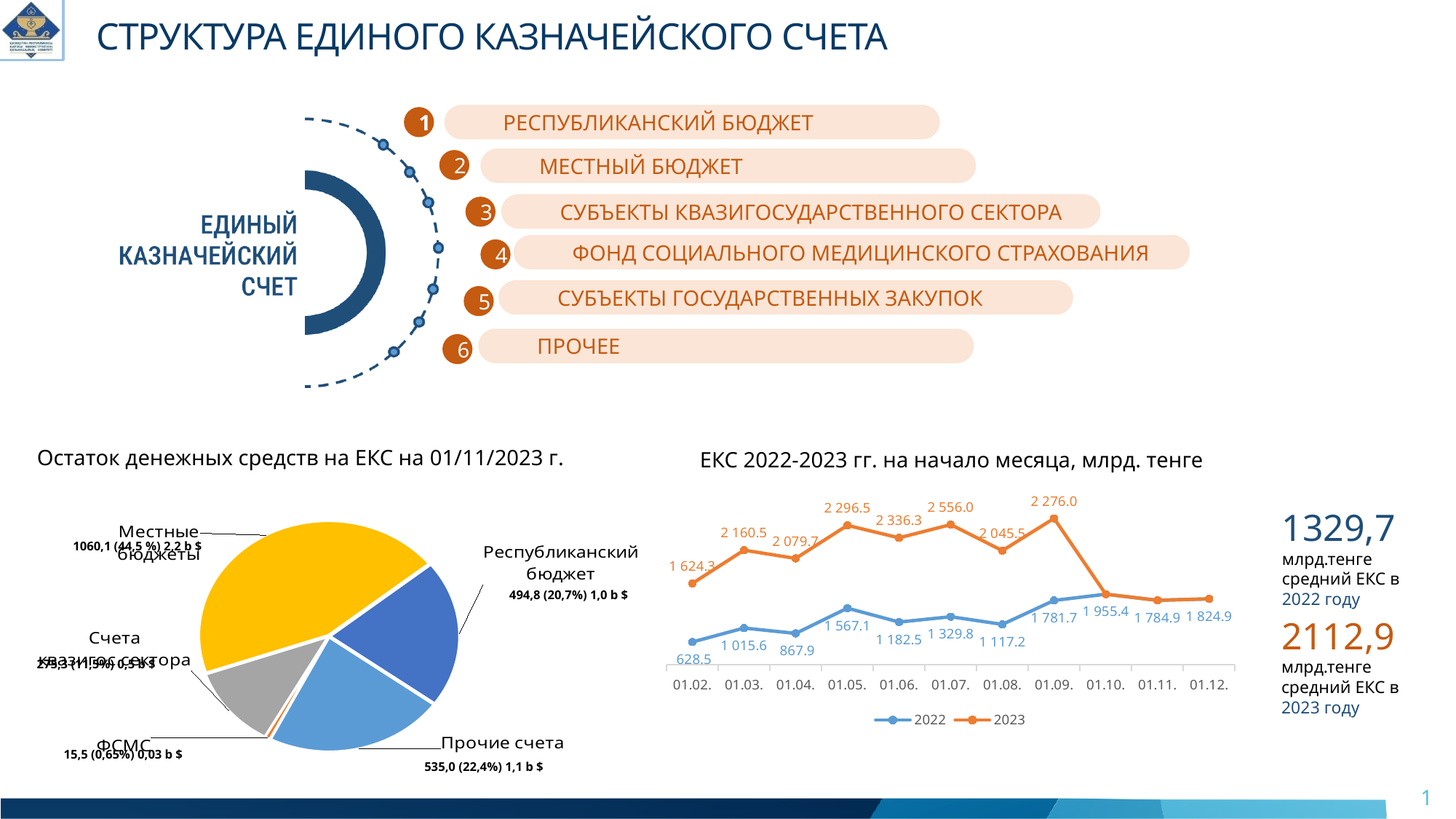
In the chart 'ЕКС 2022-2023 гг. на начало месяца, млрд. тенге', how many dates are shown on the x axis? 11 In the chart 'ЕКС 2022-2023 гг. на начало месяца, млрд. тенге', at which date is the 2022 series lowest? 01.02. In the chart 'ЕКС 2022-2023 гг. на начало месяца, млрд. тенге', what is the 2022 value at 01.09.? 1 781.7 In the pie chart 'Остаток денежных средств на ЕКС на 01/11/2023 г.', what is the value for 'Прочие счета'? 535,0 What kind of chart is the chart titled 'ЕКС 2022-2023 гг. на начало месяца, млрд. тенге'? line chart In the chart 'ЕКС 2022-2023 гг. на начало месяца, млрд. тенге', what is the 2023 value at 01.05.? 2 296.5 In the pie chart 'Остаток денежных средств на ЕКС на 01/11/2023 г.', which slice is the smallest? ФСМС In the chart 'ЕКС 2022-2023 гг. на начало месяца, млрд. тенге', which series has the larger value at 01.03., 2022 or 2023? 2023 In the pie chart 'Остаток денежных средств на ЕКС на 01/11/2023 г.', what share does 'Местные бюджеты' have? 44,5 % In the chart 'ЕКС 2022-2023 гг. на начало месяца, млрд. тенге', how many series does the legend list? 2 In the chart 'ЕКС 2022-2023 гг. на начало месяца, млрд. тенге', what is the difference between the 2022 values at 01.12. and 01.11.? 40.0 In the chart 'ЕКС 2022-2023 гг. на начало месяца, млрд. тенге', at which date is the 2023 series highest? 01.07.